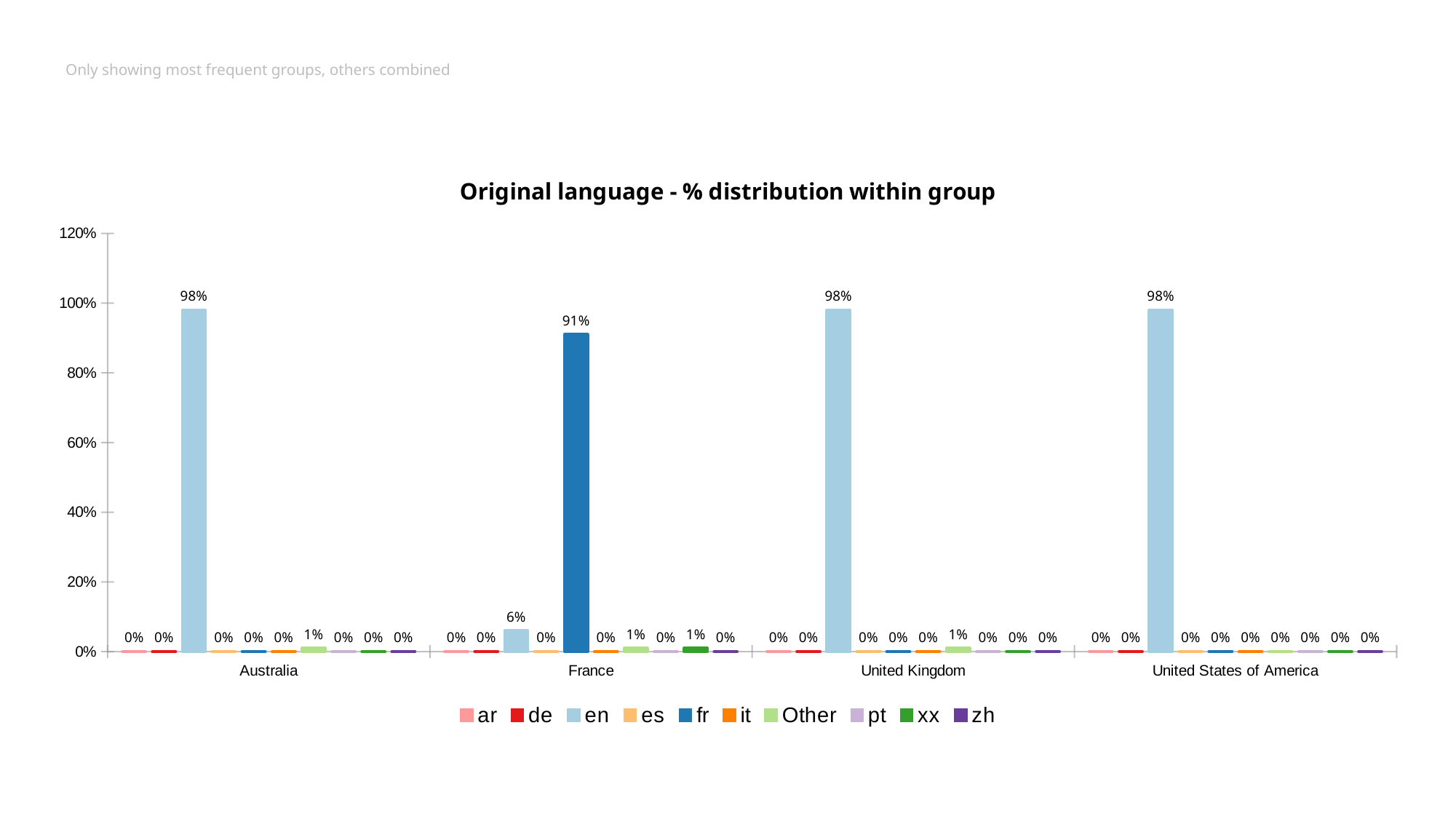
How many country groups are shown on the x axis? 4 What kind of chart is this? bar chart Which is larger: en in Australia or fr in France? en in Australia Which language has the highest value in France? fr Which language has the highest value in the United States of America? en What is the value for Other in the United Kingdom? 1% How many series does the legend list? 10 What is the difference between the fr value and the en value in France? 85% What is the value for fr in France? 91% What is the value for en in France? 6% Is the value for fr in France greater or less than 80%? greater What is the value for en in Australia? 98%